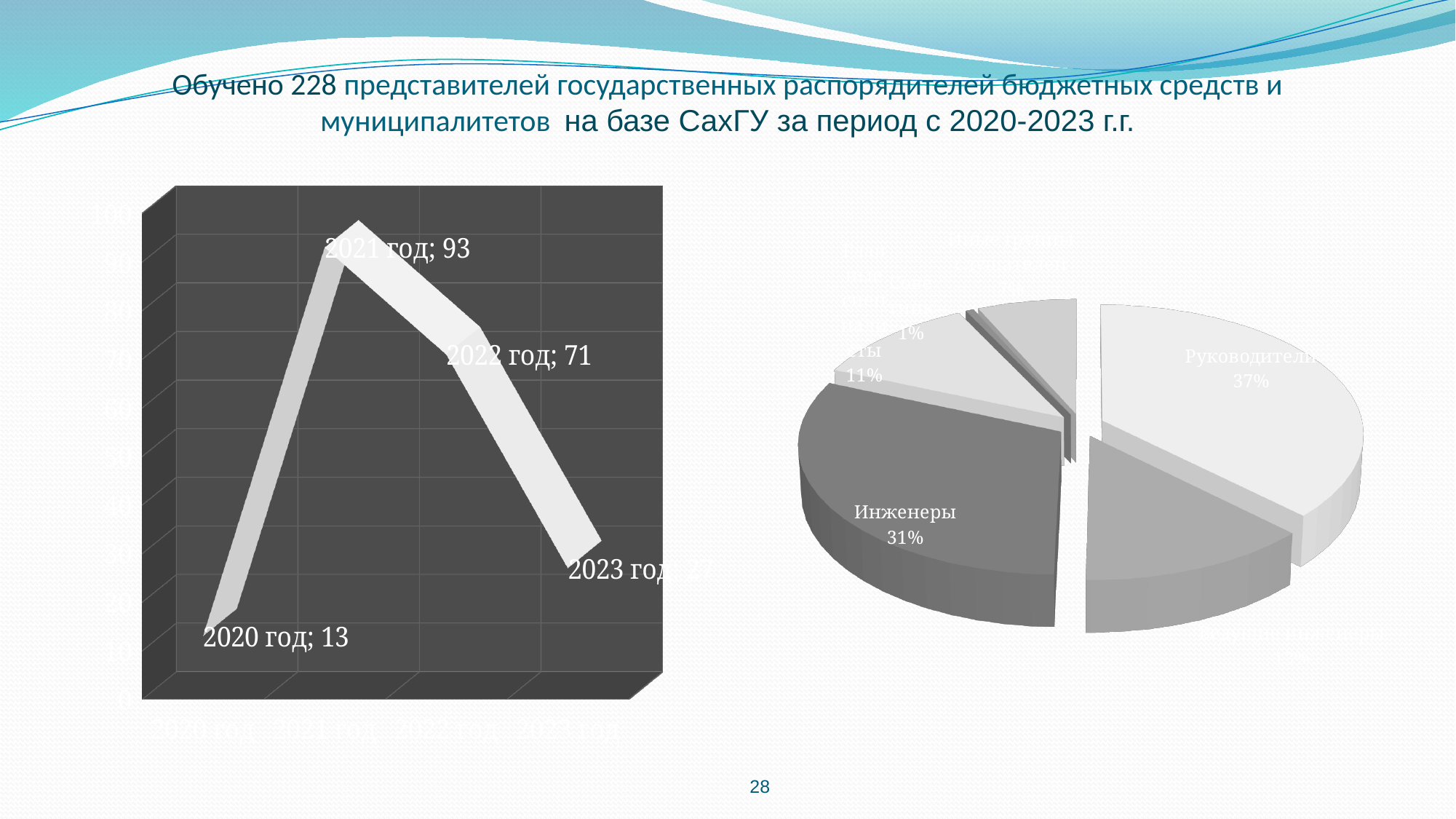
In the pie chart on the right, what share does Инженеры have? 31% What kind of chart is the chart on the left side of the slide? line chart In the left chart, how many years are plotted? 4 In the left chart, which year has the lowest value? 2020 год In the left chart, what is the value for 2020 год? 13 What kind of chart is the chart on the right side of the slide? pie chart In the left chart, what is the value for 2021 год? 93 In the left chart, what is the value for 2022 год? 71 In the pie chart on the right, what share does Руководители have? 37% In the left chart, what is the difference between the values for 2021 год and 2022 год? 22 In the left chart, which year has the highest value? 2021 год In the left chart, which is larger, the value for 2022 год or the value for 2023 год? 2022 год